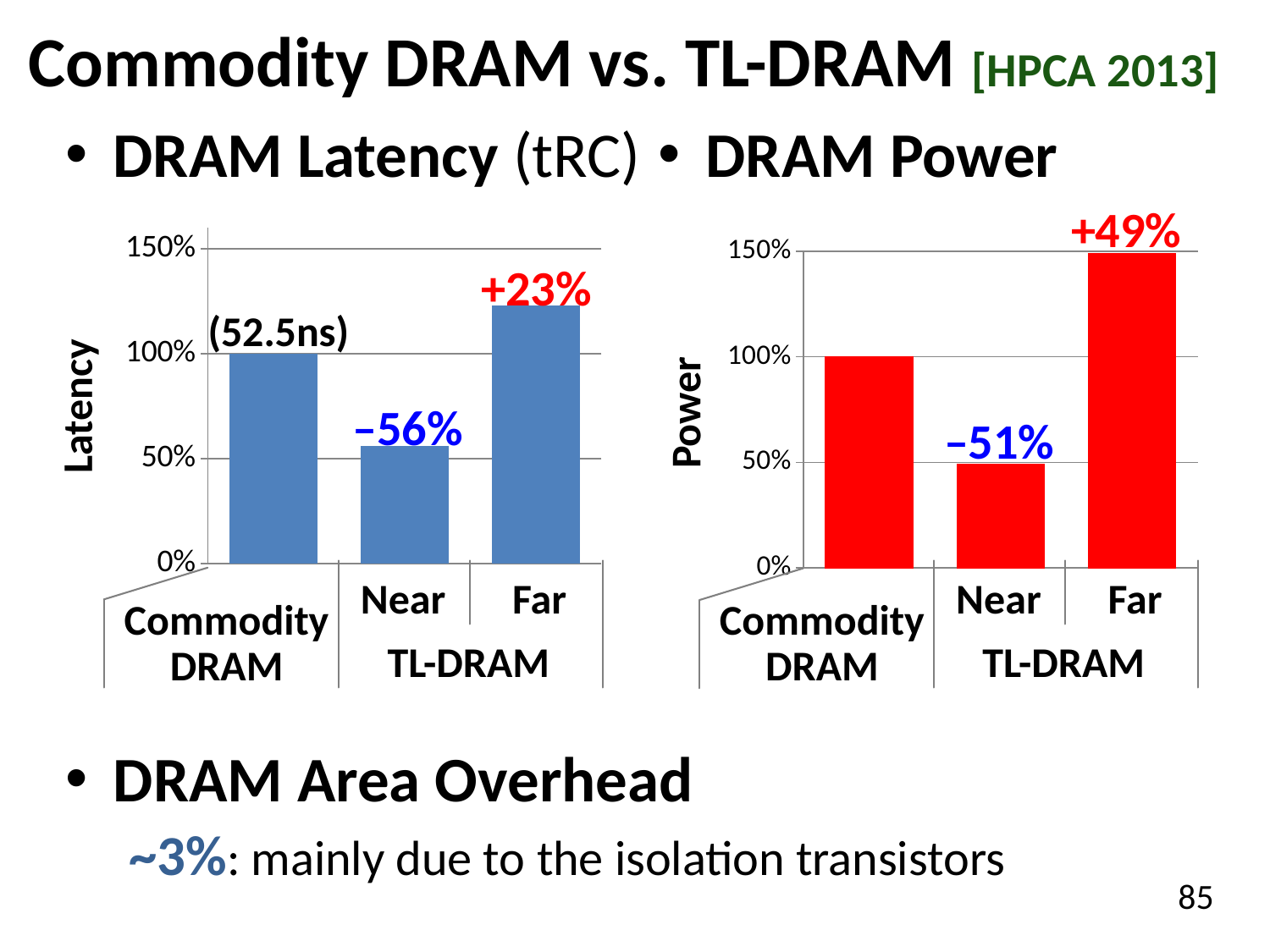
In the DRAM Power chart on the right, what percentage change is labelled above the Far TL-DRAM bar? +49% In the DRAM Latency chart on the left, what percentage change is labelled above the Near TL-DRAM bar? –56% In the DRAM Power chart on the right, what is the power value for Commodity DRAM? 100% In the DRAM Power chart on the right, what colour are the bars? red In the DRAM Latency chart on the left, what is the latency value for Commodity DRAM? 100% In the DRAM Latency chart on the left, how many bars are plotted? 3 In the DRAM Power chart on the right, which bar is the highest? Far In the DRAM Latency chart on the left, what absolute latency is printed above the Commodity DRAM bar? (52.5ns) In the DRAM Latency chart on the left, is the value for Near greater or less than 100%? less In the DRAM Latency chart on the left, which bar is the lowest? Near What kind of chart is the DRAM Latency chart on the left? bar chart In the DRAM Latency chart on the left, what percentage change is labelled above the Far TL-DRAM bar? +23%